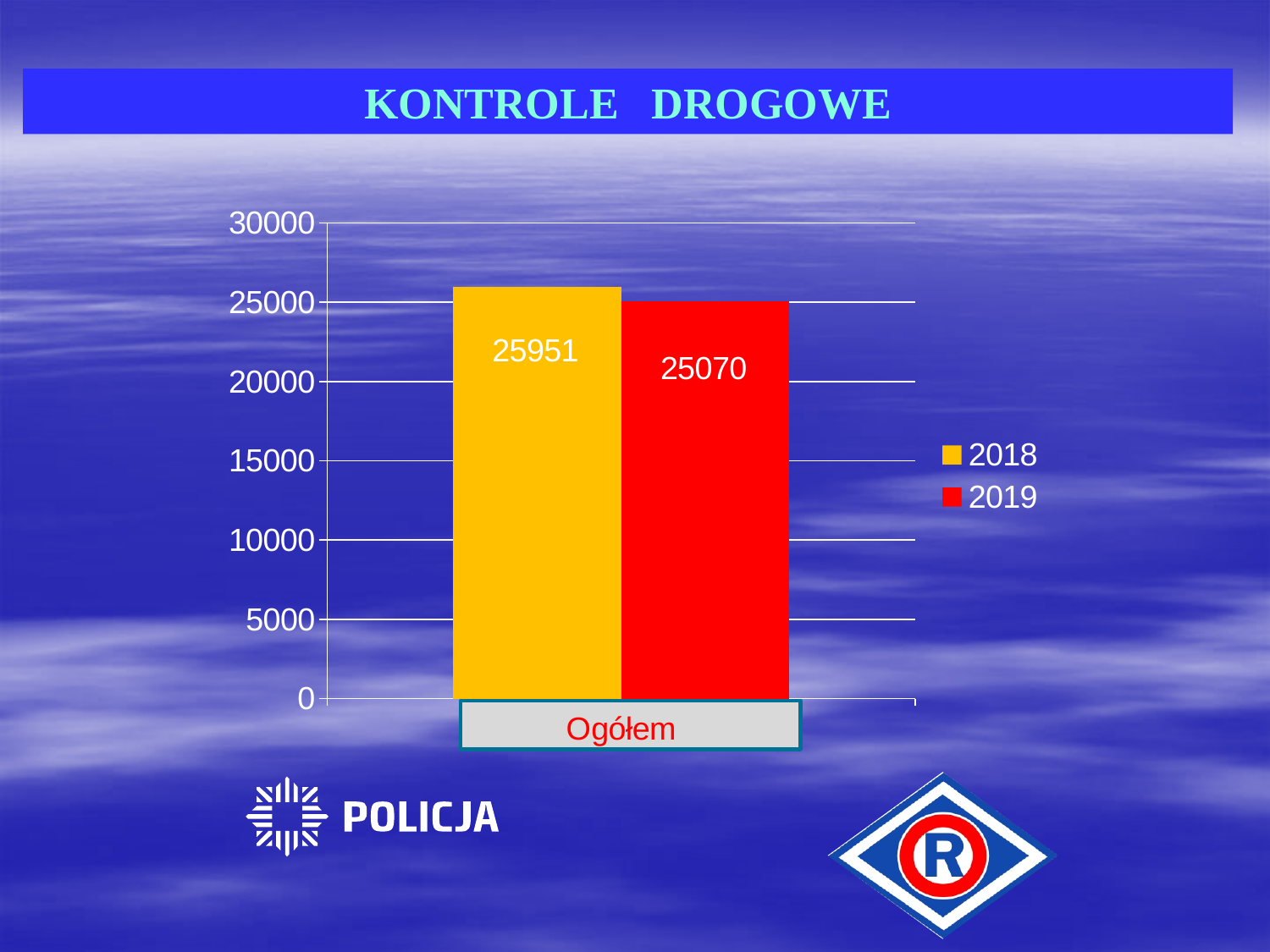
What is the label of the category on the x axis? Ogółem What is the title of the slide? KONTROLE DROGOWE Is the value for 2018 greater or less than 30000? less What is the value for 2018 in the Ogółem category? 25951 Is the value for 2019 greater or less than 25000? greater How many series does the legend list? 2 What is the value for 2019 in the Ogółem category? 25070 How many categories are shown on the x axis? 1 Which colour represents the 2019 series? red What kind of chart is shown on the slide? bar chart What is the difference between the 2018 and 2019 values for Ogółem? 881 Which series has the higher value for Ogółem, 2018 or 2019? 2018